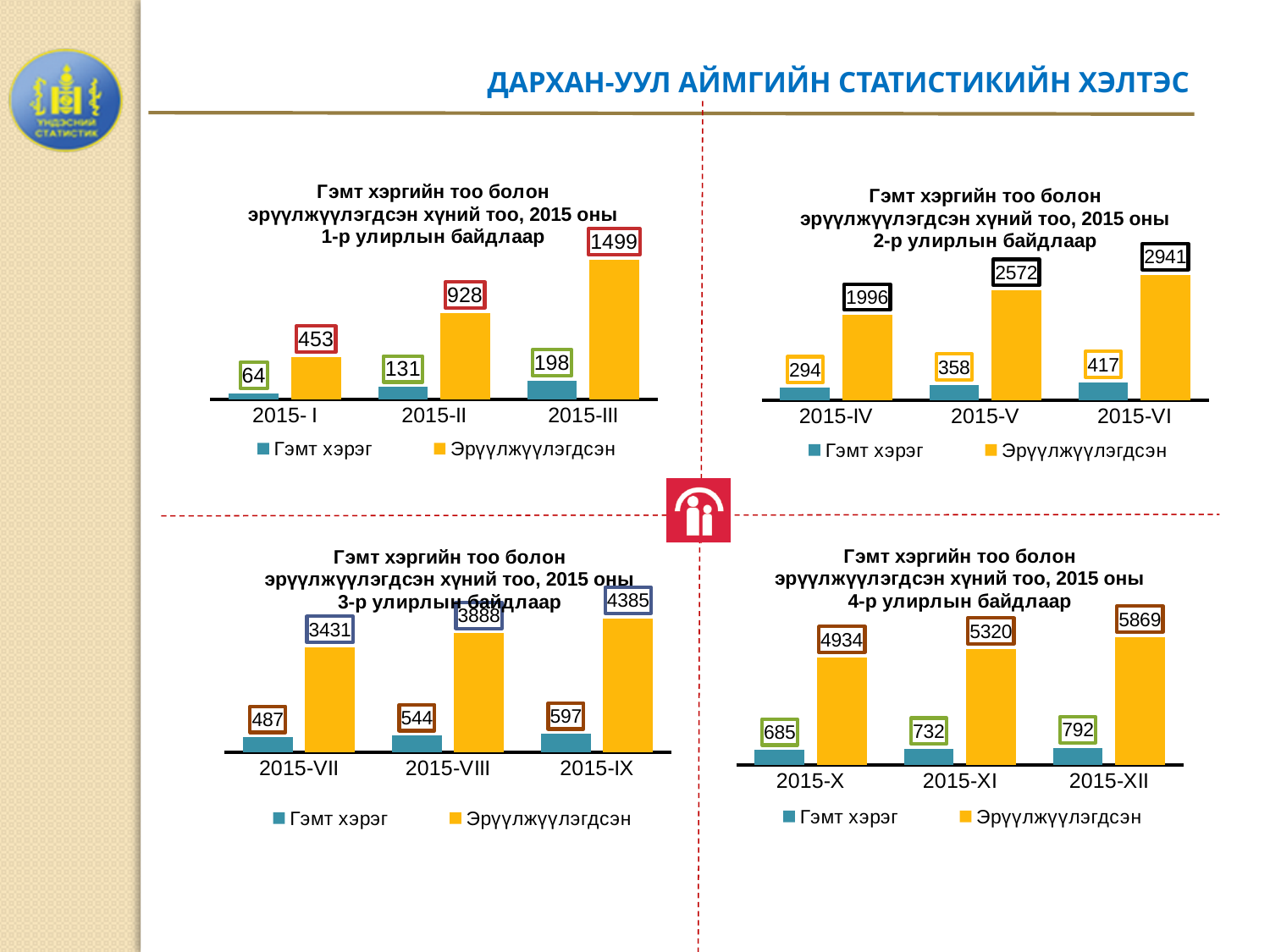
In the top-right chart (2-р улирлын байдлаар), which month has the highest Гэмт хэрэг value? 2015-VI In the bottom-right chart (4-р улирлын байдлаар), what is the difference between the Гэмт хэрэг values for 2015-XII and 2015-X? 107 How many series does the legend of the top-left chart (1-р улирлын байдлаар) list? 2 In the top-left chart (1-р улирлын байдлаар), what is the value of Эрүүлжүүлэгдсэн for 2015-III? 1499 In the bottom-left chart (3-р улирлын байдлаар), do the Эрүүлжүүлэгдсэн values rise or fall from 2015-VII to 2015-IX? rise In the bottom-right chart (4-р улирлын байдлаар), which month has the lowest Эрүүлжүүлэгдсэн value? 2015-X In the top-right chart (2-р улирлын байдлаар), what is the value of Эрүүлжүүлэгдсэн for 2015-V? 2572 In the bottom-right chart (4-р улирлын байдлаар), is the Эрүүлжүүлэгдсэн value for 2015-XI larger or smaller than the value for 2015-XII? smaller In the bottom-left chart (3-р улирлын байдлаар), what is the difference between the Эрүүлжүүлэгдсэн values for 2015-IX and 2015-VII? 954 In the top-left chart (1-р улирлын байдлаар), what is the value of Гэмт хэрэг for 2015-I? 64 In the bottom-left chart (3-р улирлын байдлаар), what is the value of Гэмт хэрэг for 2015-VIII? 544 What type of chart is the top-right chart (2-р улирлын байдлаар)? bar chart